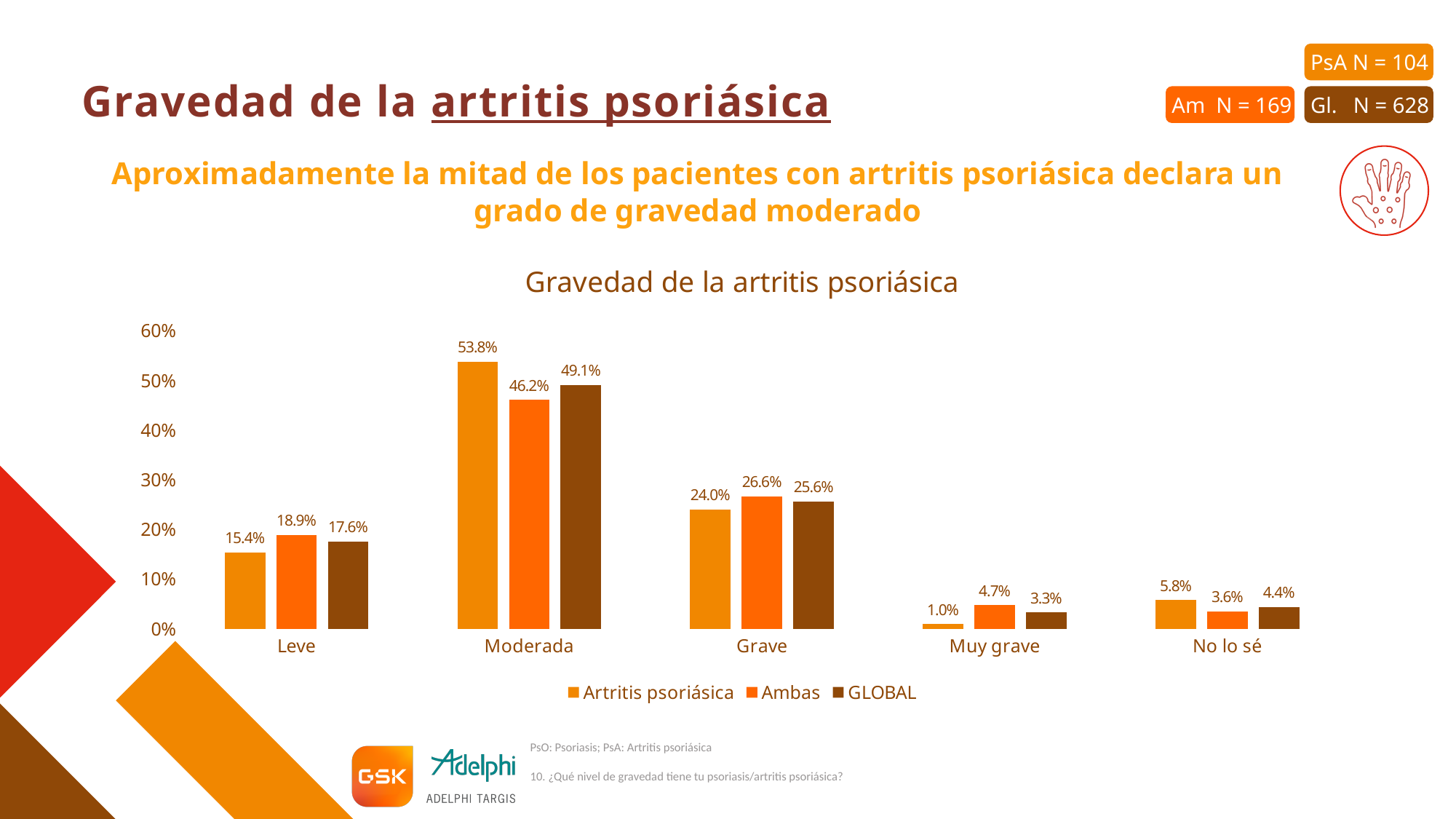
How many categories are shown on the x axis? 5 How many series does the legend list? 3 Which category has the lowest value for the Artritis psoriásica series? Muy grave What is the value for Ambas in the No lo sé category? 3.6% What is the value for Artritis psoriásica in the Moderada category? 53.8% What is the Ambas value for Leve? 18.9% In the Grave category, which is larger: the Artritis psoriásica value or the Ambas value? Ambas What is the difference between the Artritis psoriásica and Ambas values in the Moderada category? 7.6% What is the title of the chart? Gravedad de la artritis psoriásica What is the GLOBAL value for the Grave category? 25.6% Which category has the highest value for the GLOBAL series? Moderada What kind of chart is shown on the slide? Bar chart